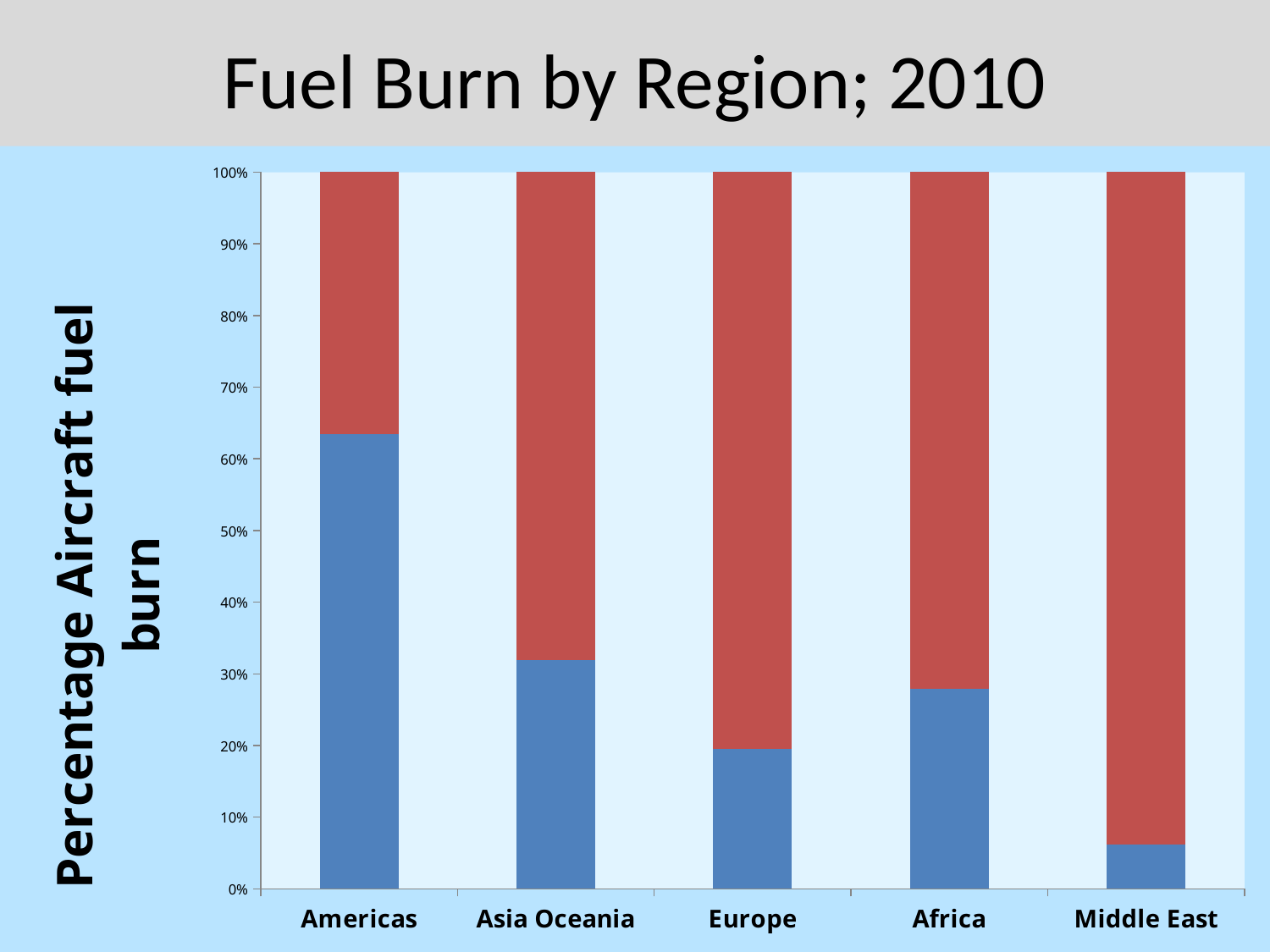
How many regions are shown on the x axis? 5 Which region has the largest blue segment? Americas Which region has the smallest blue segment? Middle East Is the blue segment for Middle East greater or less than 10%? less What kind of chart is shown on the slide? Stacked bar chart What is the label on the vertical axis? Percentage Aircraft fuel burn Is the blue segment for Europe greater or less than 10%? greater What is the total height of each stacked bar? 100% Is the blue segment for Americas greater or less than 60%? greater What is the title of the chart? Fuel Burn by Region; 2010 Which region has a larger blue segment, Europe or Africa? Africa